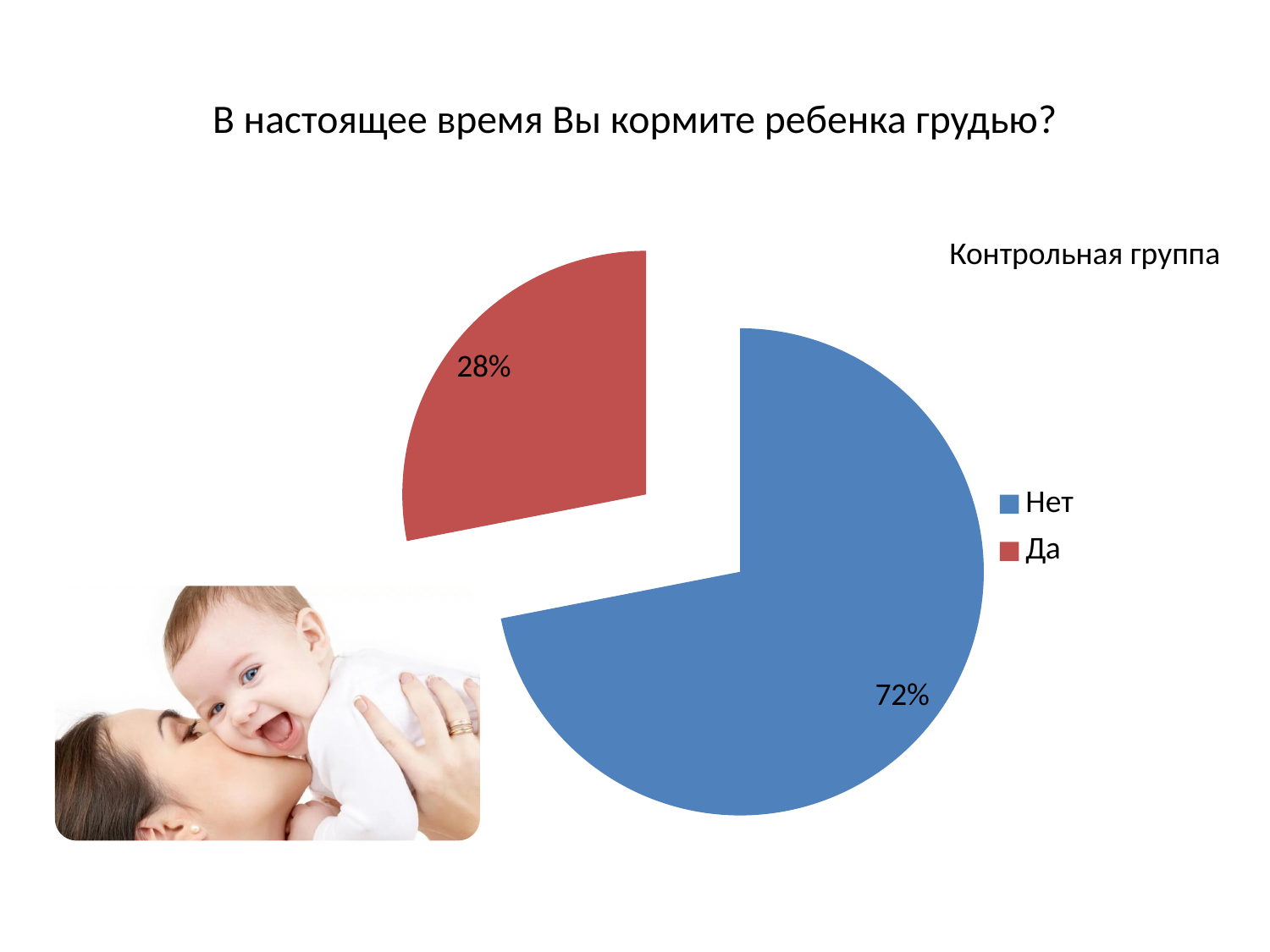
What type of chart is shown on the slide? pie chart Which slice is the largest in the pie chart? Нет What colour is the "Да" slice? red Which slice is the smallest in the pie chart? Да What is the title of the chart? Контрольная группа How many slices does the pie chart have? 2 What is the difference in percentage points between the "Нет" and "Да" slices? 44 Which is larger, the "Да" slice or the "Нет" slice? Нет How many entries does the legend list? 2 What share of the pie does the "Да" slice represent? 28% What share of the pie does the "Нет" slice represent? 72%